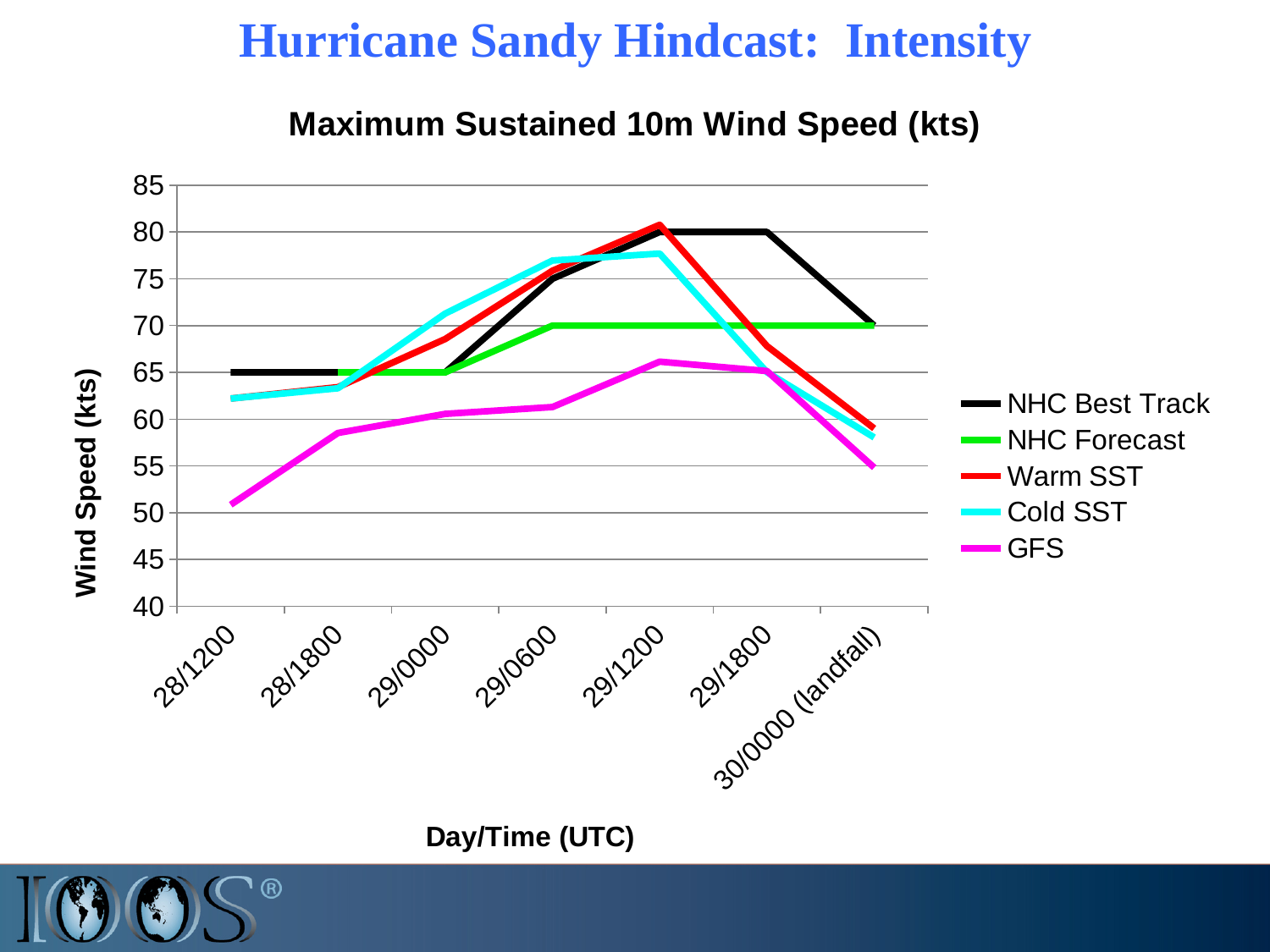
What is the NHC Best Track wind speed at 28/1200? 65 What is the NHC Forecast wind speed at 29/1800? 70 Which series has the lowest wind speed at 28/1200? GFS How many time points are shown on the x axis? 7 Which series has the highest wind speed at 29/1800? NHC Best Track How many series does the legend list? 5 What is the NHC Best Track wind speed at 29/1200? 80 What kind of chart is shown on the slide? line chart What is the NHC Best Track wind speed at 30/0000 (landfall)? 70 What is the difference between the NHC Best Track wind speed at 29/1200 and at 30/0000 (landfall)? 10 Is the GFS wind speed at 28/1200 greater or less than 55? less At 30/0000 (landfall), which is larger, the NHC Best Track value or the Warm SST value? NHC Best Track